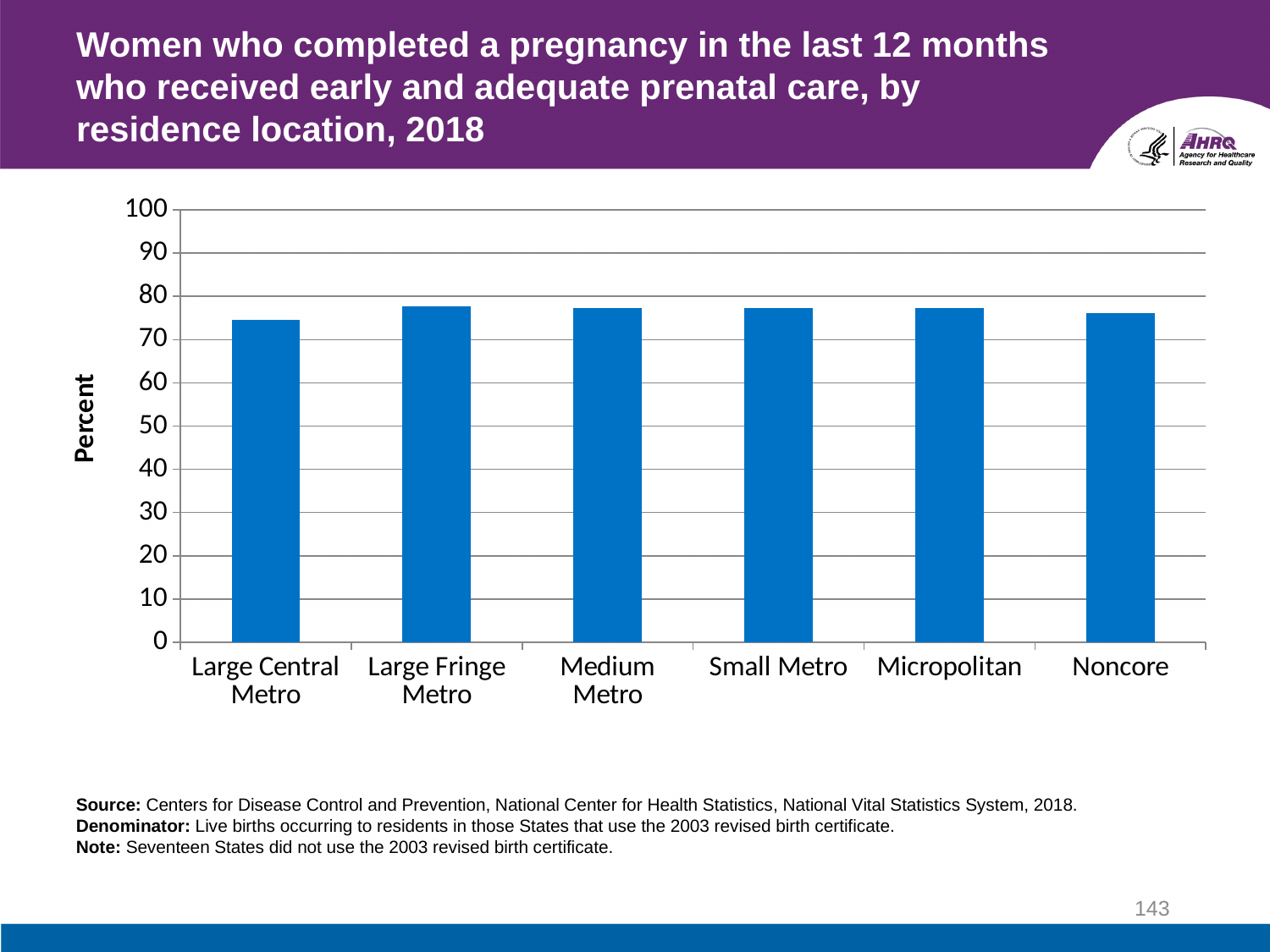
Is the value for Noncore greater or less than 70? greater How many residence location categories are shown on the x axis? 6 Which has the larger value, Large Central Metro or Large Fringe Metro? Large Fringe Metro Is the value for Small Metro greater or less than 60? greater Is the value for Micropolitan greater or less than 80? less Which has the larger value, Large Central Metro or Medium Metro? Medium Metro What year does the chart title say the data are for? 2018 What kind of chart is shown on the slide? bar chart What is the label on the y axis? Percent